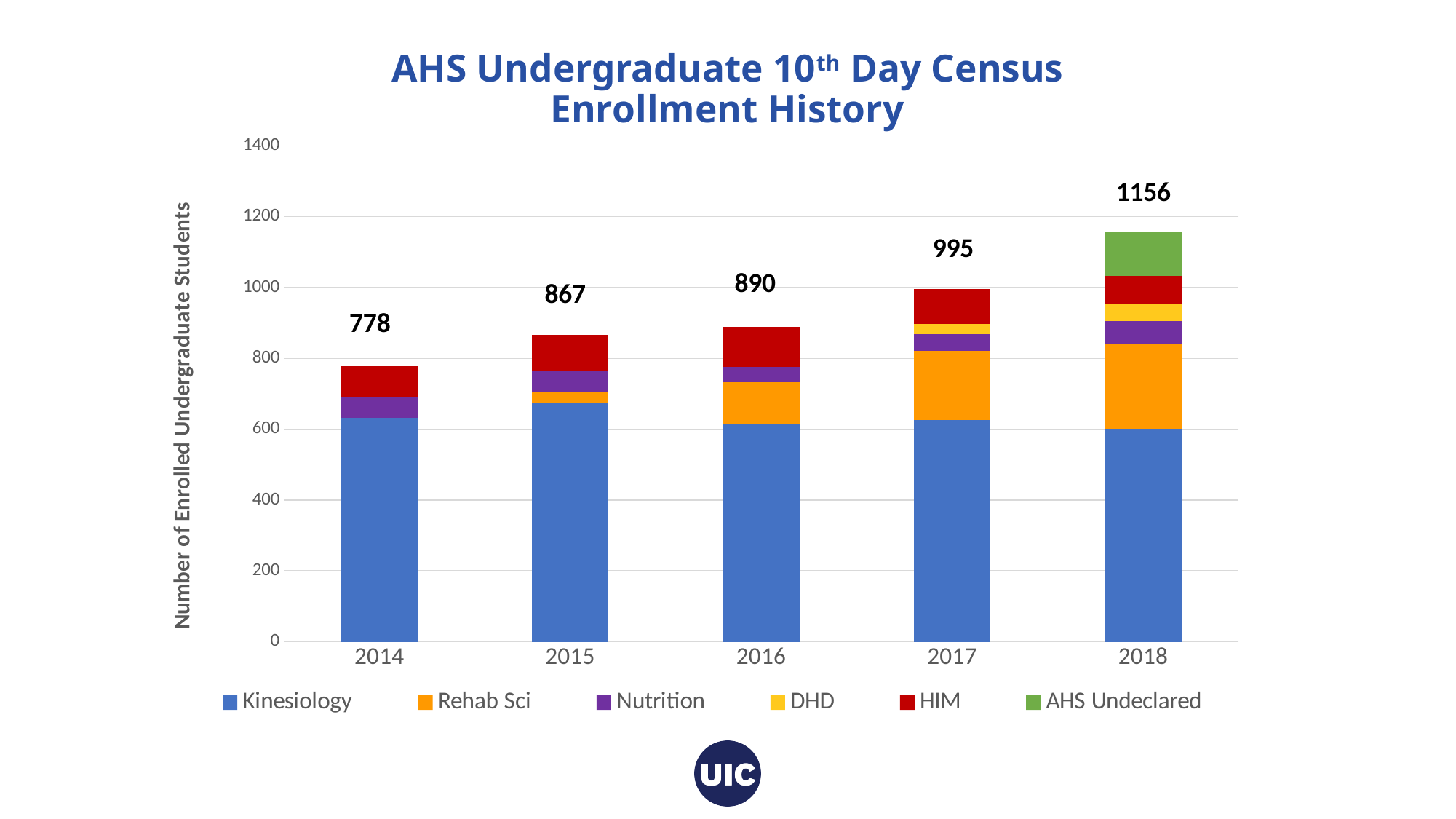
How many years are shown on the x axis? 5 Do the total enrollment values rise or fall from 2014 to 2018? rise How many series does the legend list? 6 What is the difference between the total enrollment in 2018 and in 2017? 161 What is the total enrollment shown for 2016? 890 Is the Kinesiology value for 2015 greater or less than 600? greater Which year has a larger total enrollment, 2016 or 2017? 2017 Which year has the highest total enrollment? 2018 What is the difference between the total enrollment in 2015 and in 2014? 89 What is the total enrollment shown for 2018? 1156 Which year has the lowest total enrollment? 2014 What is the total enrollment shown for 2014? 778